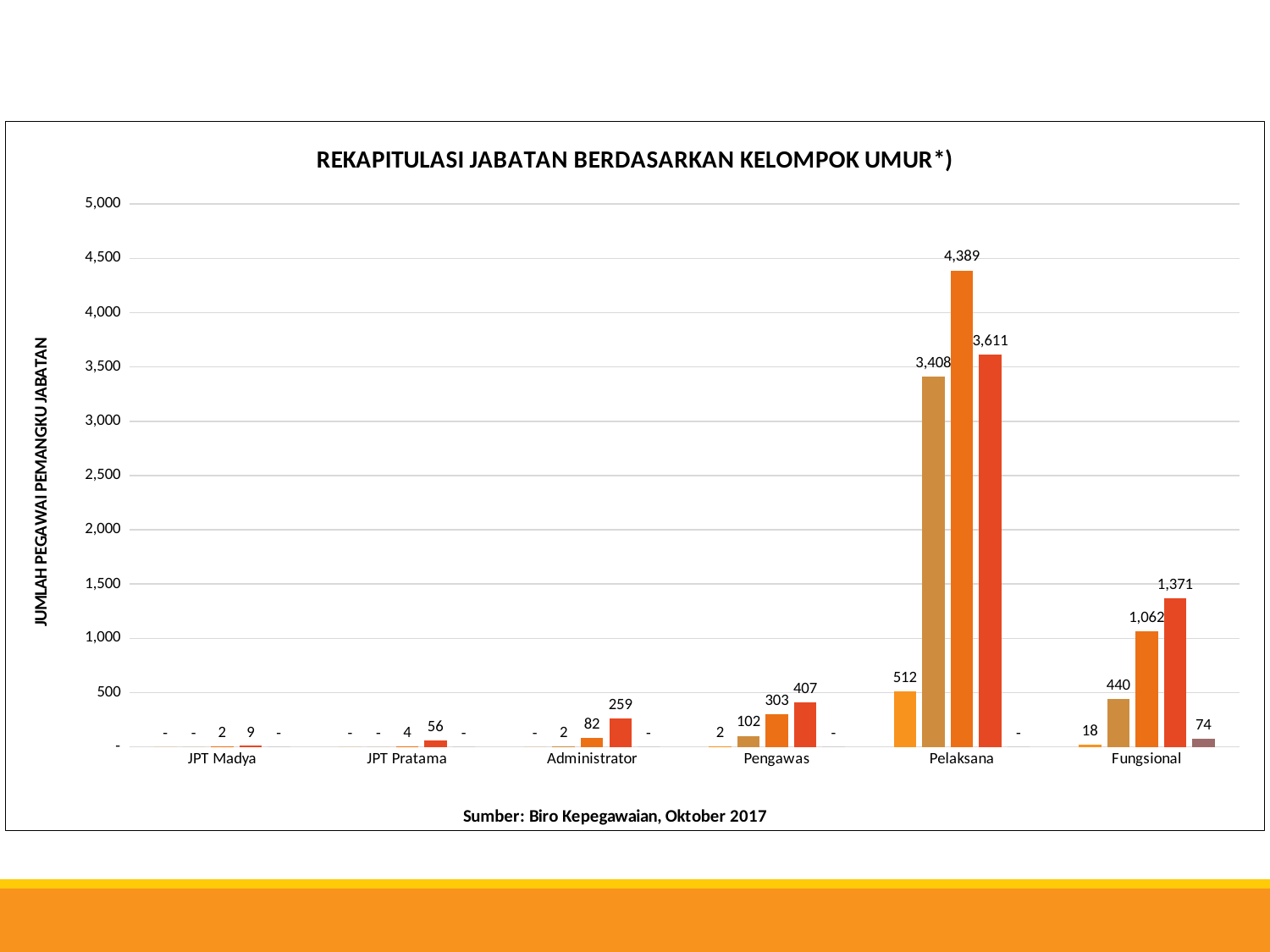
What is the highest value labelled in the Pelaksana group? 4,389 How many job categories are shown along the x axis? 6 Which is larger: the tallest bar in Administrator or the tallest bar in Pengawas? Pengawas What is the value of the tallest bar in the Pengawas group? 407 What is the title of the chart? REKAPITULASI JABATAN BERDASARKAN KELOMPOK UMUR*) Is the tallest bar in the Pelaksana group greater or less than 4,000? greater What is the difference between the two tallest bars in the Pelaksana group (4,389 and 3,611)? 778 What is the value of the last (fifth) bar in the Fungsional group? 74 What is the value of the second bar (tan-coloured) in the Pelaksana group? 3,408 What is the value of the tallest bar in the Fungsional group? 1,371 What kind of chart is shown on the slide? bar chart Which job category has the tallest bar overall? Pelaksana